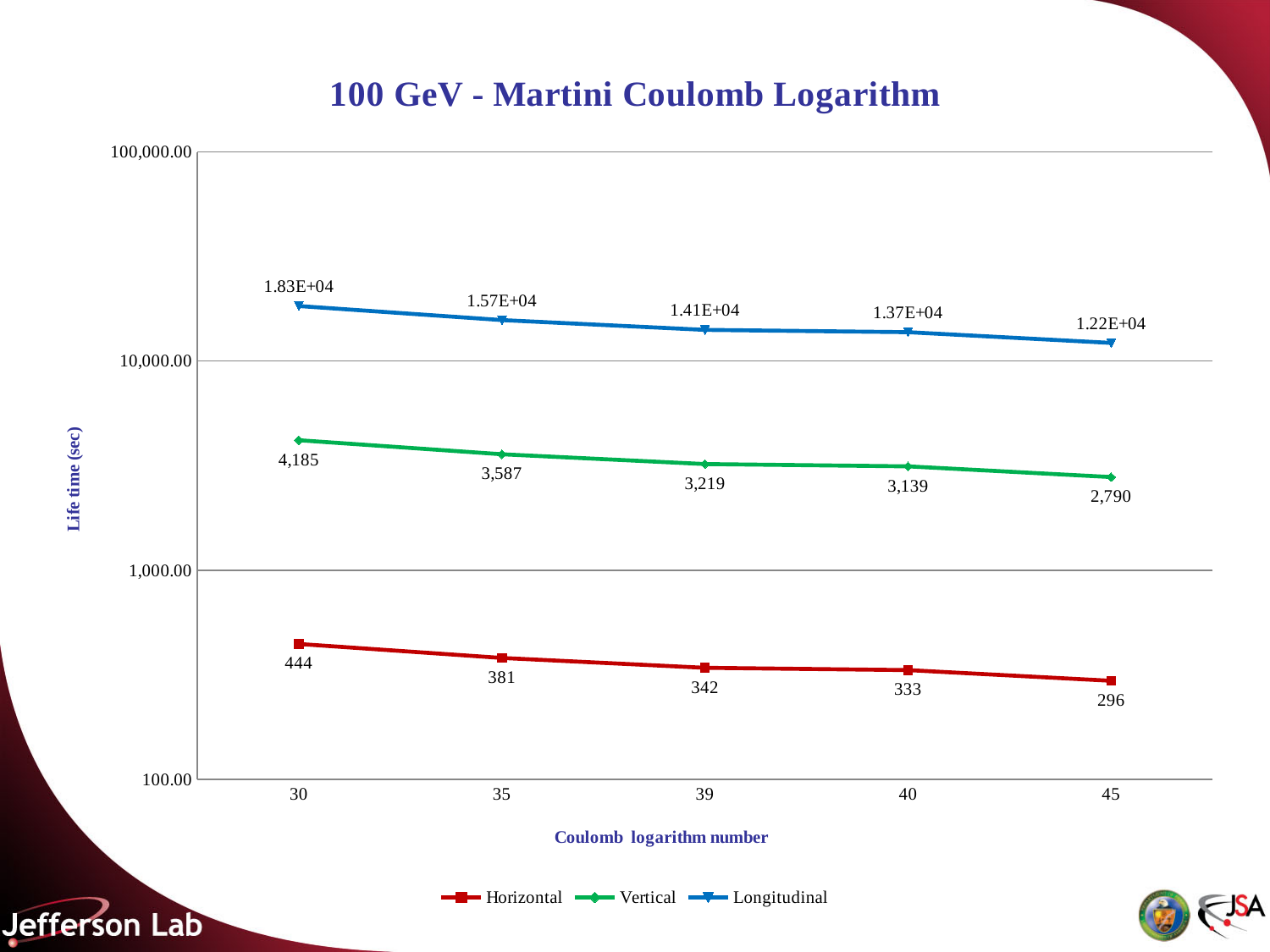
At which Coulomb logarithm number is the Horizontal life time lowest? 45 What is the difference between the Horizontal life time at 30 and at 45? 148 What is the Vertical life time at Coulomb logarithm number 39? 3,219 What is the Vertical life time at Coulomb logarithm number 45? 2,790 What is the Horizontal life time at Coulomb logarithm number 30? 444 At which Coulomb logarithm number is the Vertical life time highest? 30 How many series does the legend list? 3 How many Coulomb logarithm numbers are plotted on the x axis? 5 Which is larger, the Vertical life time at 35 or at 40? 35 What is the Longitudinal life time at Coulomb logarithm number 45? 1.22E+04 Is the Horizontal life time at 40 greater or less than 1,000.00? less What kind of chart is shown on the slide? line chart